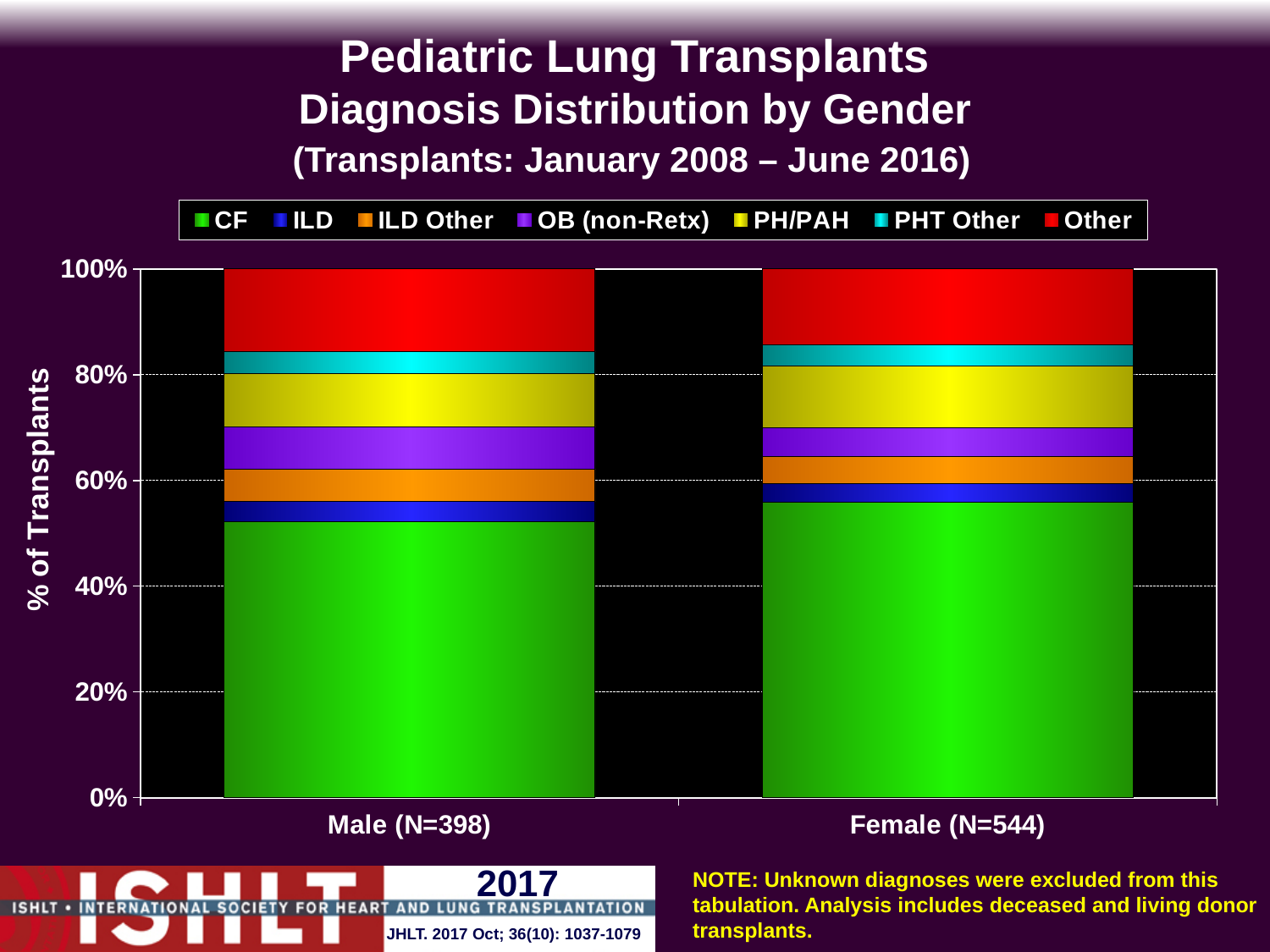
Which diagnosis makes up the largest segment of the Female bar? CF Is the CF share of the Female bar greater or less than 40%? greater What is the title of the chart? Pediatric Lung Transplants Diagnosis Distribution by Gender (Transplants: January 2008 – June 2016) What is the N shown for the Male category? 398 Is the CF share of the Male bar greater or less than 60%? less What is the N shown for the Female category? 544 Which diagnosis makes up the largest segment of the Male bar? CF What kind of chart is shown on the slide? Stacked bar chart How many gender categories are plotted on the x axis? 2 Which diagnosis series is shown in green in the legend? CF What is the label of the y axis? % of Transplants How many diagnosis series does the legend list? 7